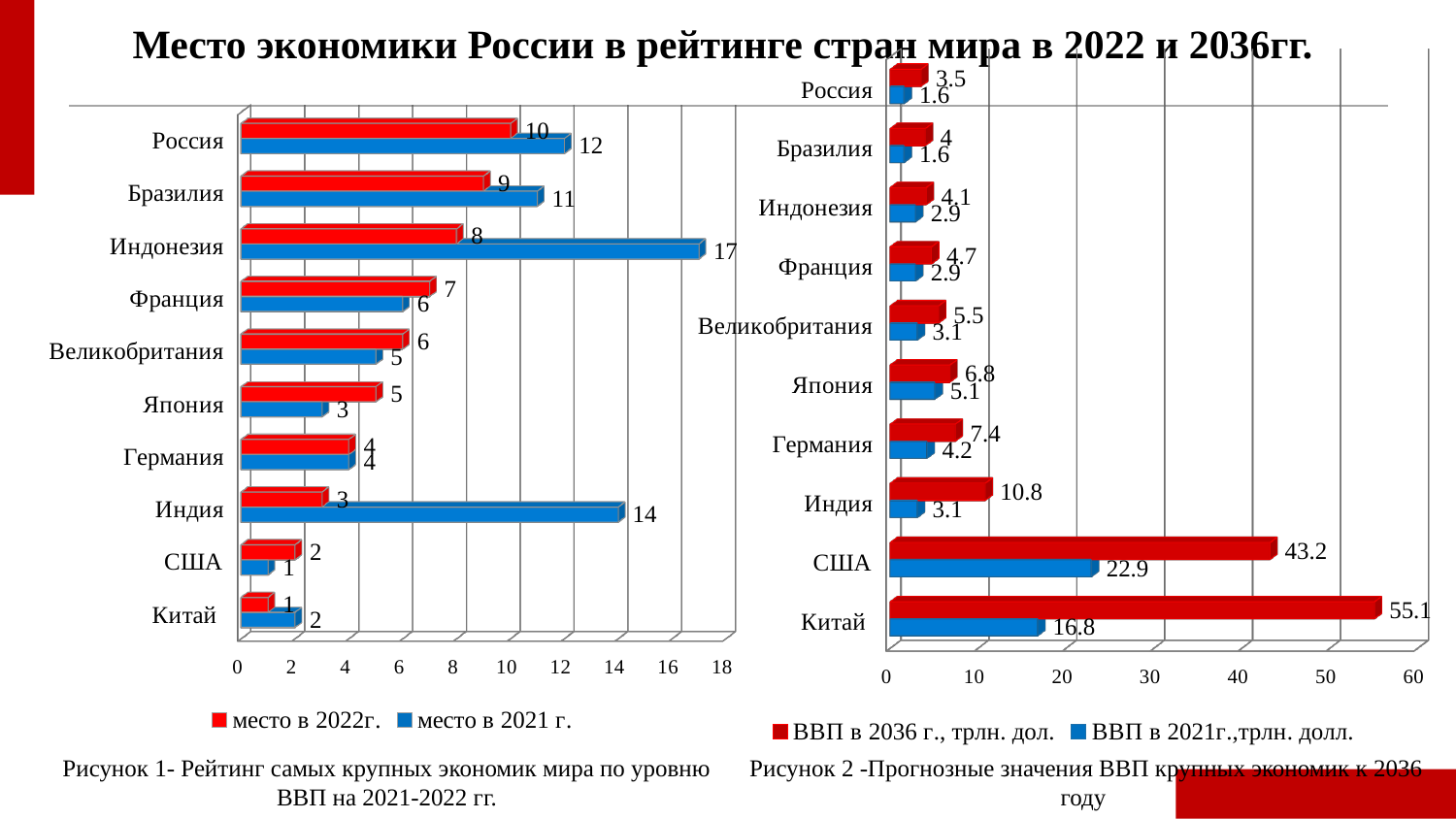
In the right chart (Рисунок 2), what is the value of 'ВВП в 2021г.,трлн. долл.' for США? 22.9 In the right chart (Рисунок 2), which is larger: the 'ВВП в 2036 г., трлн. дол.' value for Индия or for Германия? Индия In the left chart (Рисунок 1), what is the difference between the 'место в 2021 г.' and 'место в 2022г.' values for Индия? 11 In the right chart (Рисунок 2), what is the difference between the 'ВВП в 2036 г., трлн. дол.' values for Китай and США? 11.9 What type of chart is the left chart (Рисунок 1)? Bar chart In the left chart (Рисунок 1), what is the value of 'место в 2022г.' for Россия? 10 In the left chart (Рисунок 1), which country has the highest 'место в 2021 г.' value? Индонезия In the left chart (Рисунок 1), what is the value of 'место в 2021 г.' for Индонезия? 17 How many series does the legend of the right chart (Рисунок 2) list? 2 In the left chart (Рисунок 1), how many countries are shown? 10 In the right chart (Рисунок 2), what is the value of 'ВВП в 2036 г., трлн. дол.' for Китай? 55.1 In the right chart (Рисунок 2), which country has the lowest 'ВВП в 2036 г., трлн. дол.' value? Россия